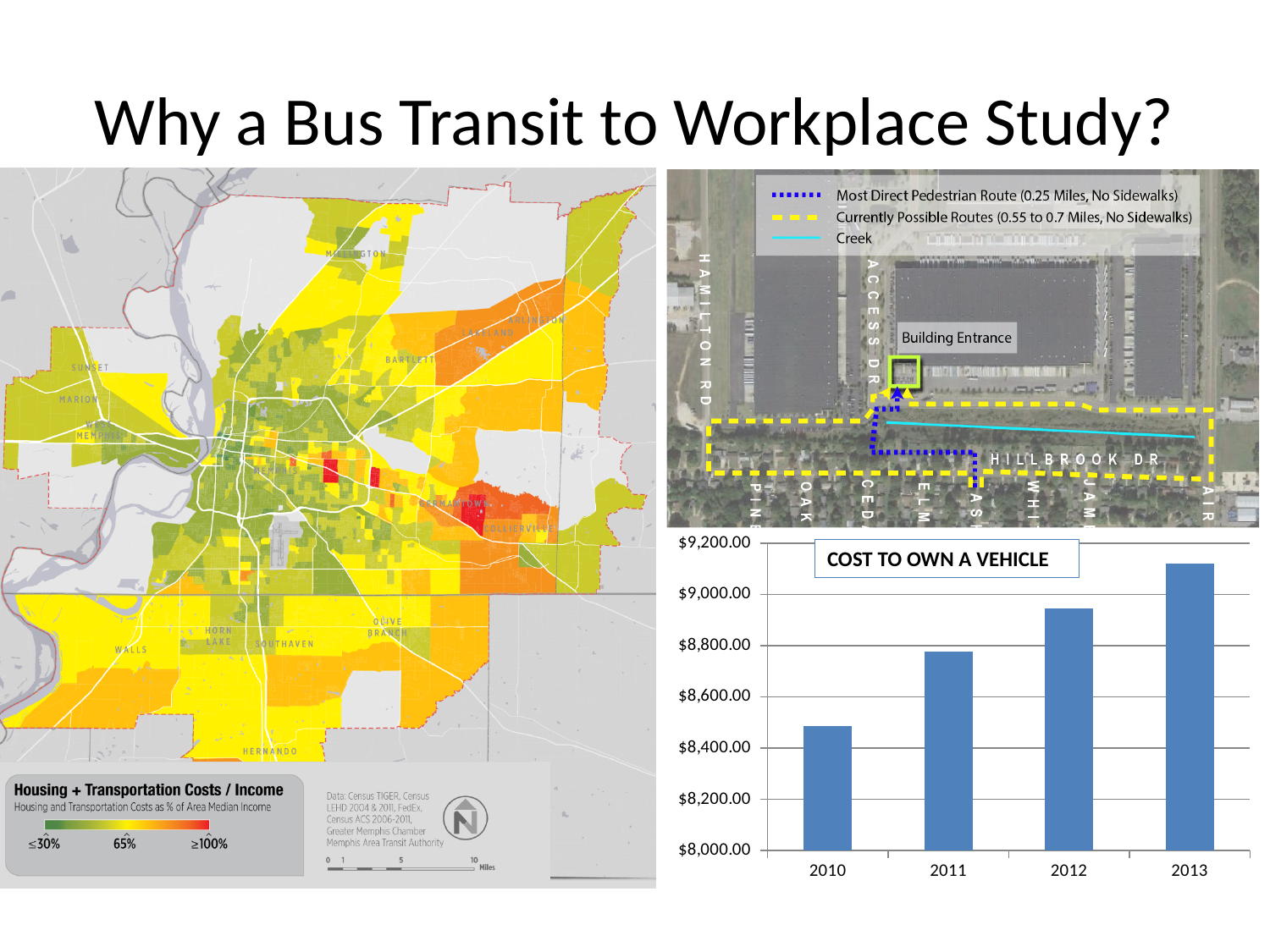
In the "COST TO OWN A VEHICLE" chart, is the value for 2011 greater or less than $8,600.00? greater What kind of chart is the "COST TO OWN A VEHICLE" chart? bar chart In the "COST TO OWN A VEHICLE" chart, how many years are shown on the x axis? 4 In the "COST TO OWN A VEHICLE" chart, is the value for 2013 greater or less than $9,000.00? greater In the "COST TO OWN A VEHICLE" chart, which year has the lowest value? 2010 What is the title of the bar chart on the slide? COST TO OWN A VEHICLE In the "COST TO OWN A VEHICLE" chart, which year has the highest value? 2013 In the "COST TO OWN A VEHICLE" chart, do the values rise or fall from 2010 to 2013? rise In the "COST TO OWN A VEHICLE" chart, is the value for 2012 greater or less than $9,000.00? less In the "COST TO OWN A VEHICLE" chart, which is larger, the value for 2011 or the value for 2013? 2013